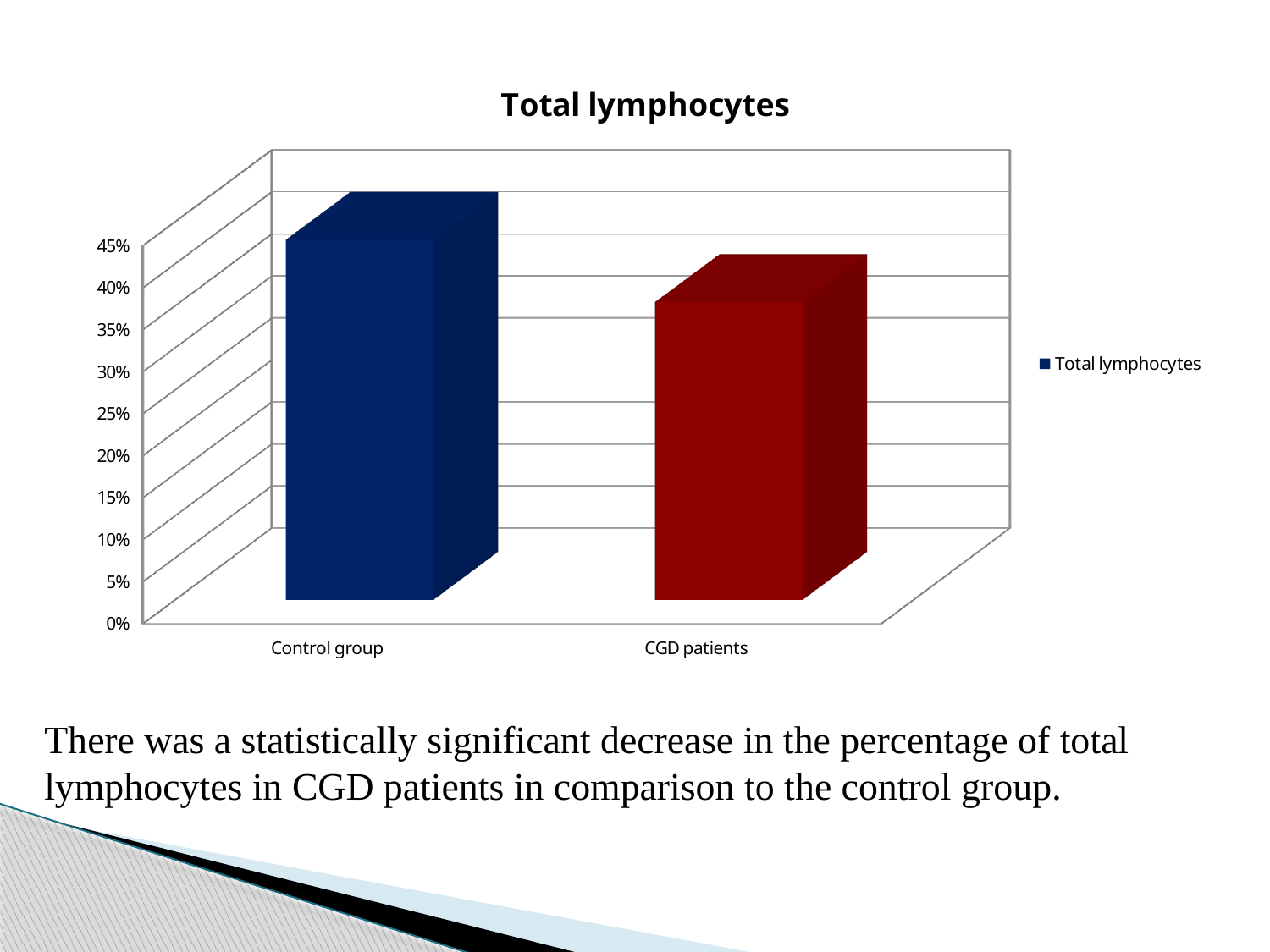
How many categories are shown on the x axis of the chart? 2 Which category has the lowest value for total lymphocytes? CGD patients Do the values rise or fall from Control group to CGD patients? fall What colour is the bar for CGD patients? red How many series does the legend list? 1 Is the value for Control group greater or less than 40%? greater Which category has the highest value for total lymphocytes? Control group Is the value for CGD patients greater or less than 40%? less Is the value for CGD patients greater or less than 30%? greater Which is larger, the value for Control group or the value for CGD patients? Control group What is the title of the chart? Total lymphocytes What kind of chart is shown on the slide? bar chart